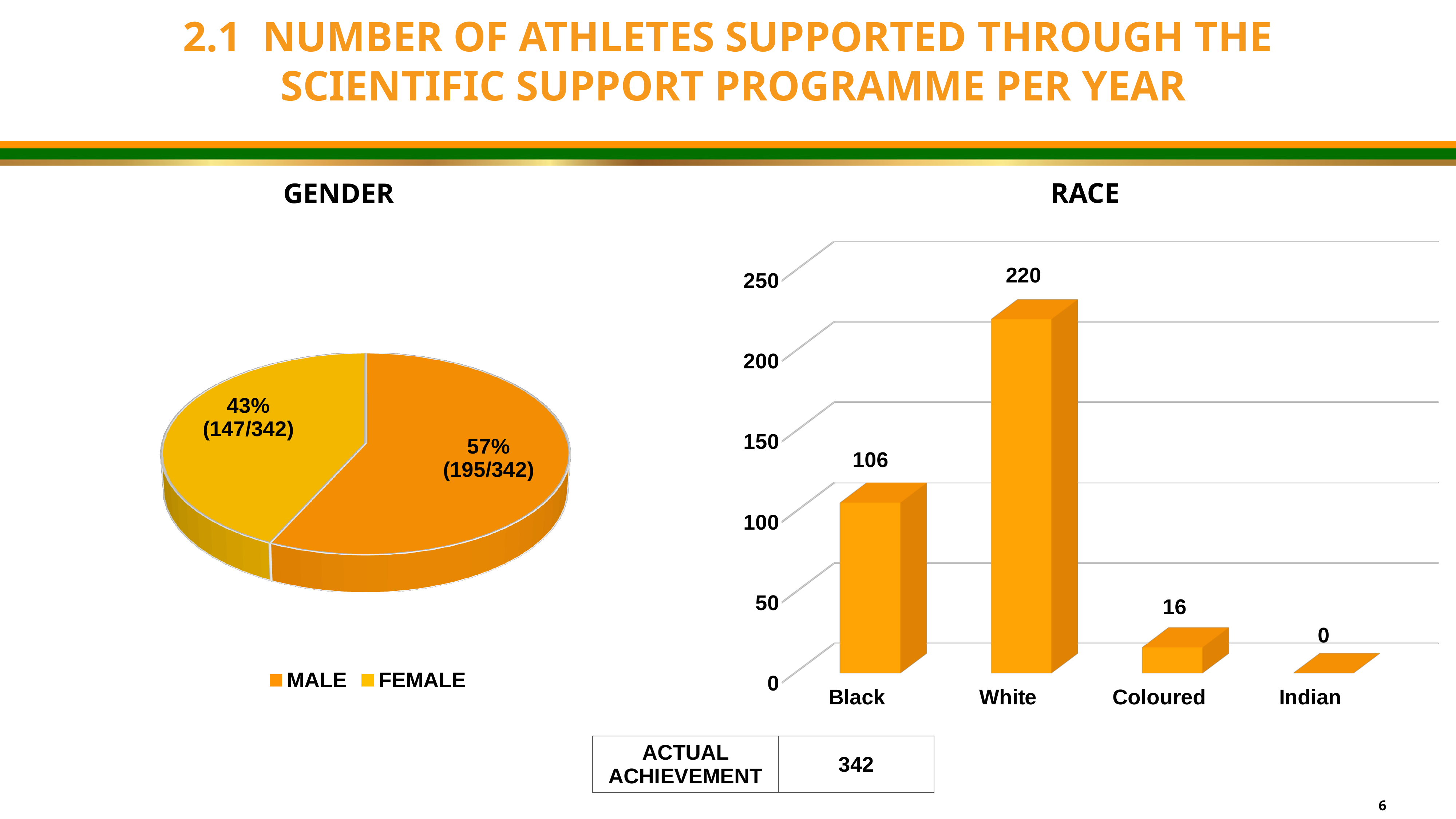
In the RACE chart, which category has the highest value? White In the GENDER chart, what share of the pie is MALE? 57% In the RACE chart, what is the value for Black? 106 In the RACE chart, what is the value for White? 220 In the RACE chart, which category has the lowest value? Indian In the RACE chart, how many categories are shown on the x axis? 4 In the GENDER chart, what share of the pie is FEMALE? 43% How many entries does the legend of the GENDER chart list? 2 What kind of chart is the RACE chart? Bar chart In the RACE chart, what is the difference between the values for White and Black? 114 In the RACE chart, what is the value for Coloured? 16 In the GENDER chart, which slice is larger, MALE or FEMALE? MALE